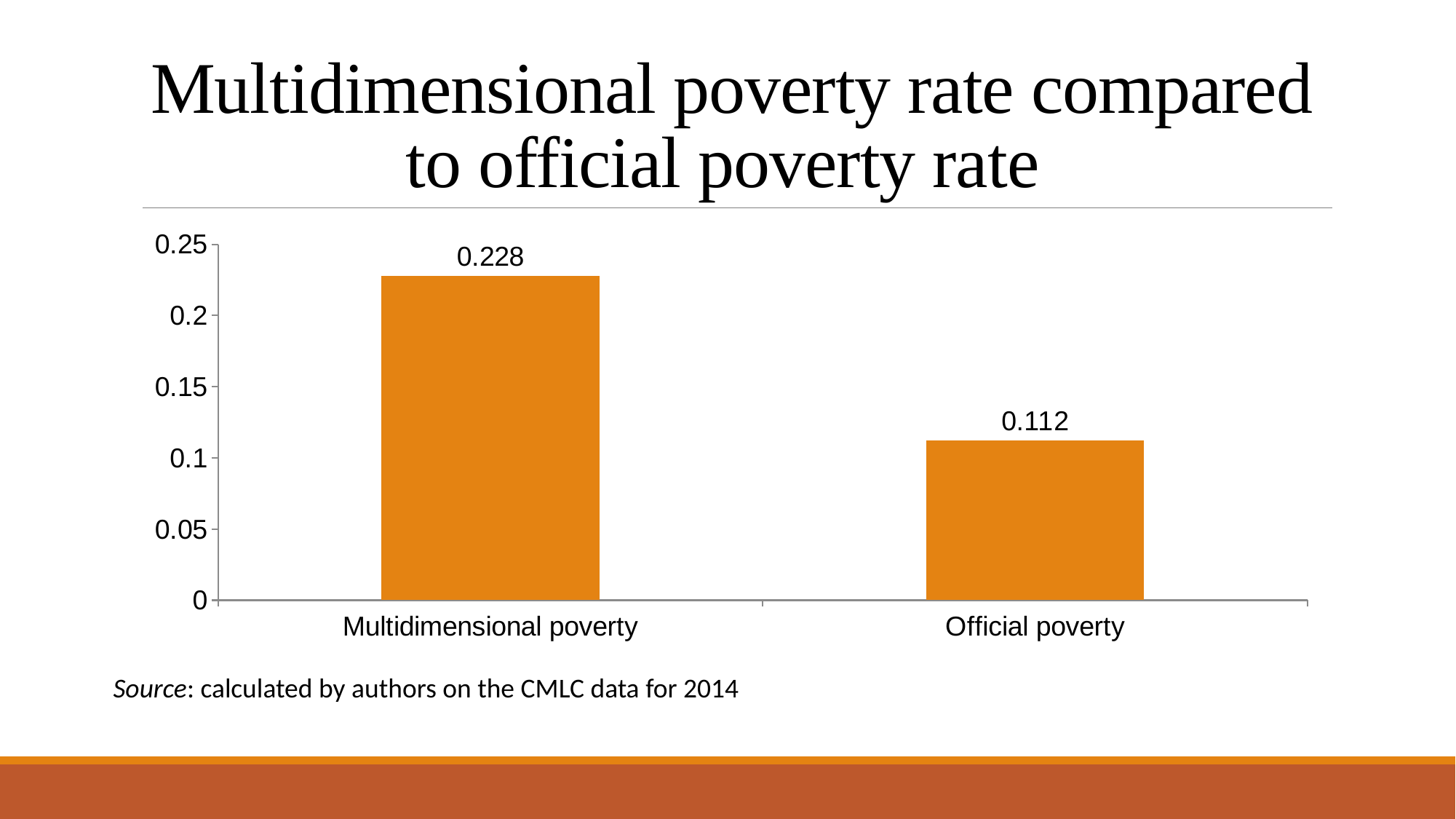
What is the highest value shown on the vertical axis? 0.25 What is the title of the slide? Multidimensional poverty rate compared to official poverty rate How many categories are shown on the chart? 2 Which is larger, the value for Multidimensional poverty or the value for Official poverty? Multidimensional poverty What is the value for Multidimensional poverty? 0.228 Which category has the lowest value? Official poverty What is the difference between the Multidimensional poverty value and the Official poverty value? 0.116 What kind of chart is shown on the slide? bar chart Is the value for Official poverty greater or less than 0.15? less What is the value for Official poverty? 0.112 Is the value for Multidimensional poverty greater or less than 0.2? greater Which category has the highest value? Multidimensional poverty